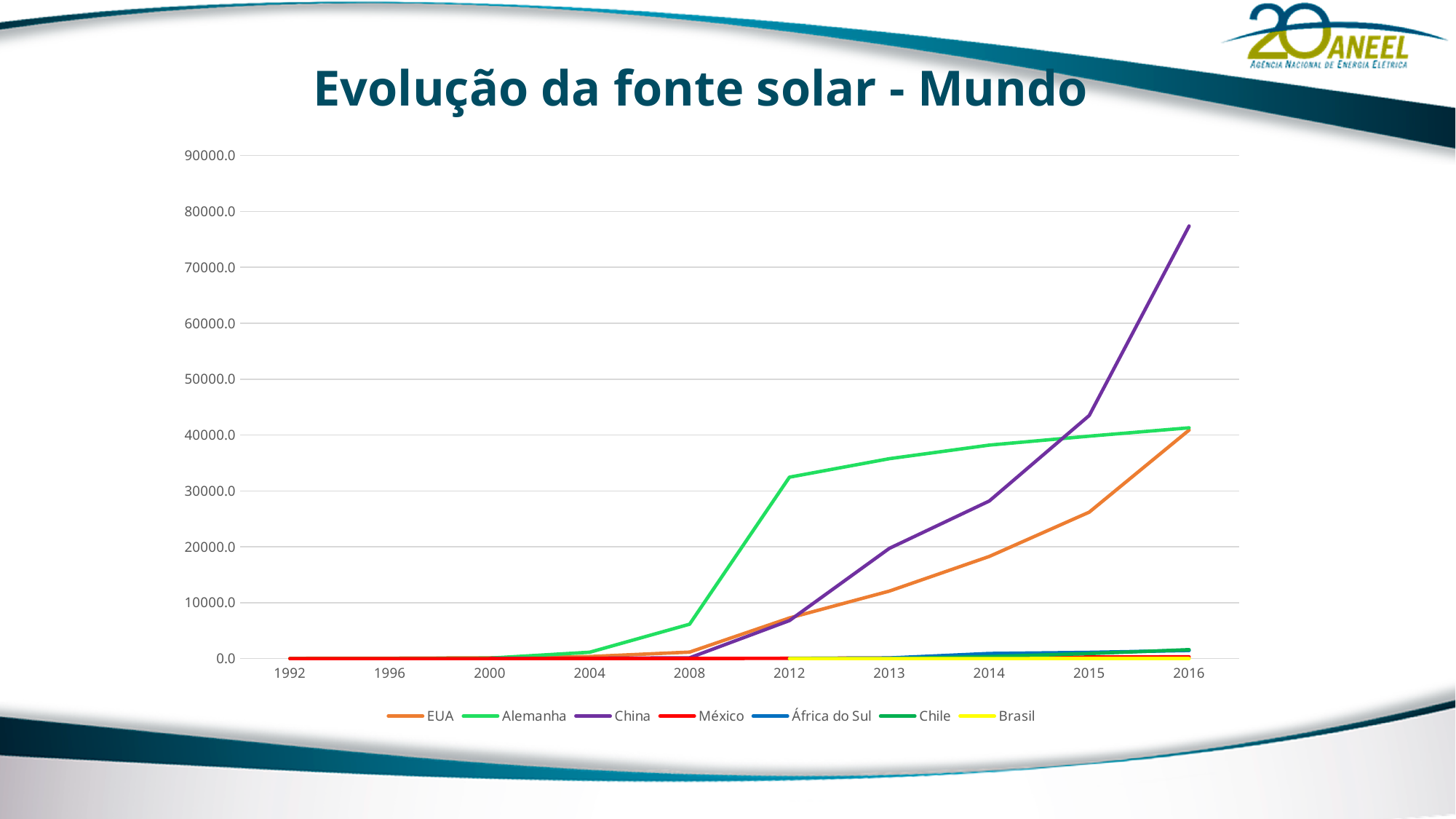
Is the value for China in 2014 greater or less than 20000? greater Is the value for EUA in 2015 greater or less than 30000? less Does the value for China rise or fall from 2012 to 2016? rise Which series has the highest value in 2016? China Is the value for China in 2016 greater or less than 70000? greater Which is larger in 2013, the value for Alemanha or the value for China? Alemanha Which is larger in 2016, the value for China or the value for EUA? China What kind of chart is shown on the slide? line chart What is the title of the chart? Evolução da fonte solar - Mundo How many series does the legend list? 7 How many years are marked along the x axis? 10